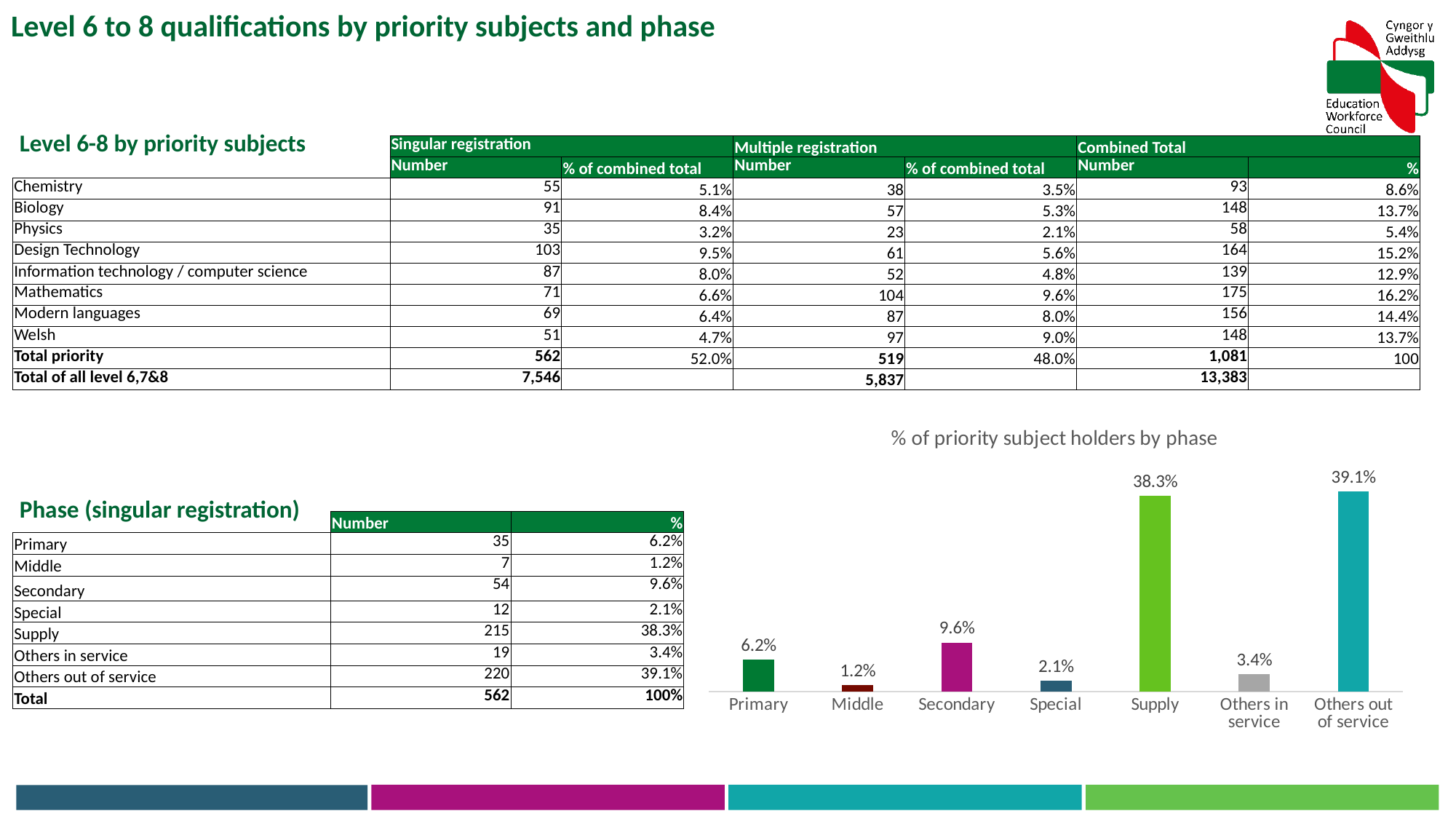
What is the difference between the values for Others out of service and Supply? 0.8% What is the title of the chart on the slide? % of priority subject holders by phase Which phase has the highest value in the chart? Others out of service How many phase categories are plotted in the chart? 7 Which is larger, the value for Primary or the value for Others in service? Primary What is the value for Supply in the chart? 38.3% What is the value for Secondary in the chart? 9.6% What is the value for Others in service in the chart? 3.4% Which phase has the lowest value in the chart? Middle What is the difference between the values for Secondary and Special? 7.5% What type of chart is shown on the slide? bar chart What is the value for Middle in the chart? 1.2%